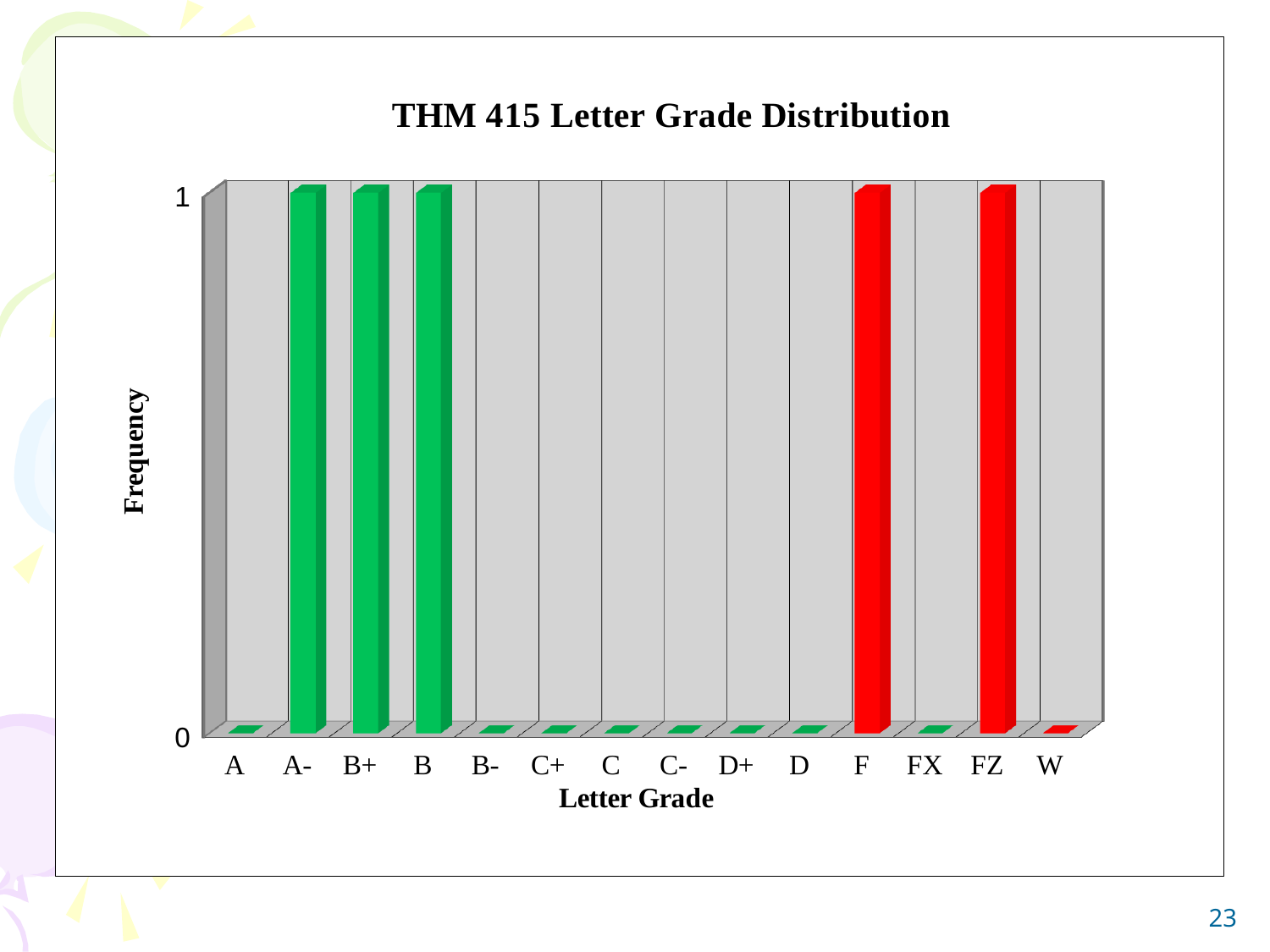
What is the frequency for the letter grade C? 0 What is the title of the chart? THM 415 Letter Grade Distribution How many letter grade categories are shown on the x axis? 14 What kind of chart is shown on the slide? bar chart What is the frequency for the letter grade FZ? 1 What is the difference between the frequency for B+ and the frequency for D? 1 Which is larger, the frequency for B or the frequency for B-? B How many letter grades have a frequency of 1? 5 What is the frequency for the letter grade A-? 1 What is the label of the y axis? Frequency What is the frequency for the letter grade F? 1 What is the frequency for the letter grade A? 0